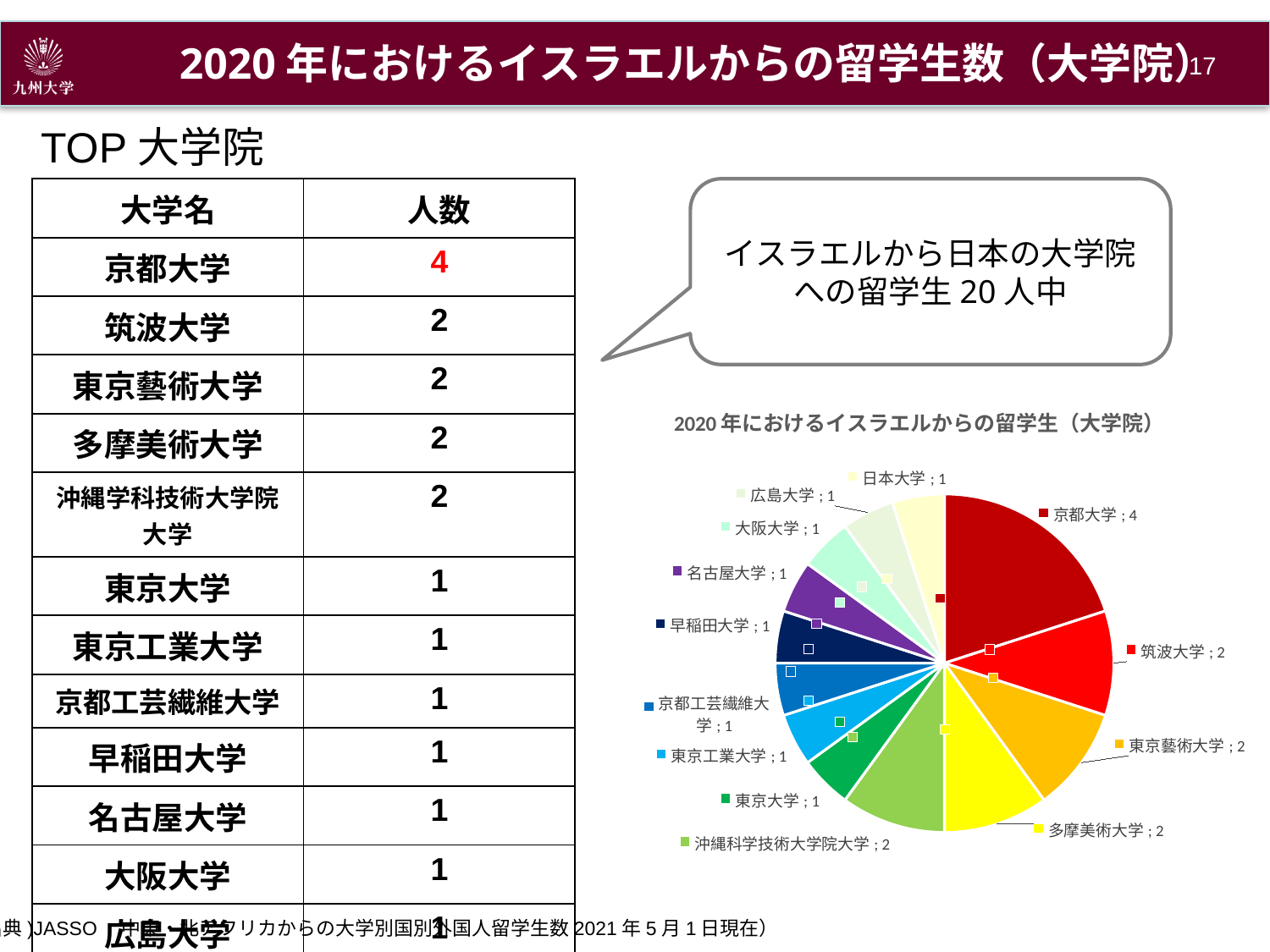
In the pie chart, how many students are shown for 筑波大学? 2 What is the difference between the values for 京都大学 and 東京藝術大学 in the pie chart? 2 In the pie chart, how many students are shown for 京都大学? 4 In the pie chart, which is larger, the value for 多摩美術大学 or the value for 名古屋大学? 多摩美術大学 How many universities (slices) are shown in the pie chart? 13 In the pie chart, how many students are shown for 沖縄科学技術大学院大学? 2 In the pie chart, how many students are shown for 早稲田大学? 1 What colour is the slice for 京都大学 in the pie chart? dark red What share of the pie chart does 京都大学 represent? 20% What is the title of the pie chart? 2020年におけるイスラエルからの留学生（大学院） Which university has the largest slice in the pie chart? 京都大学 What kind of chart is shown on the slide? pie chart